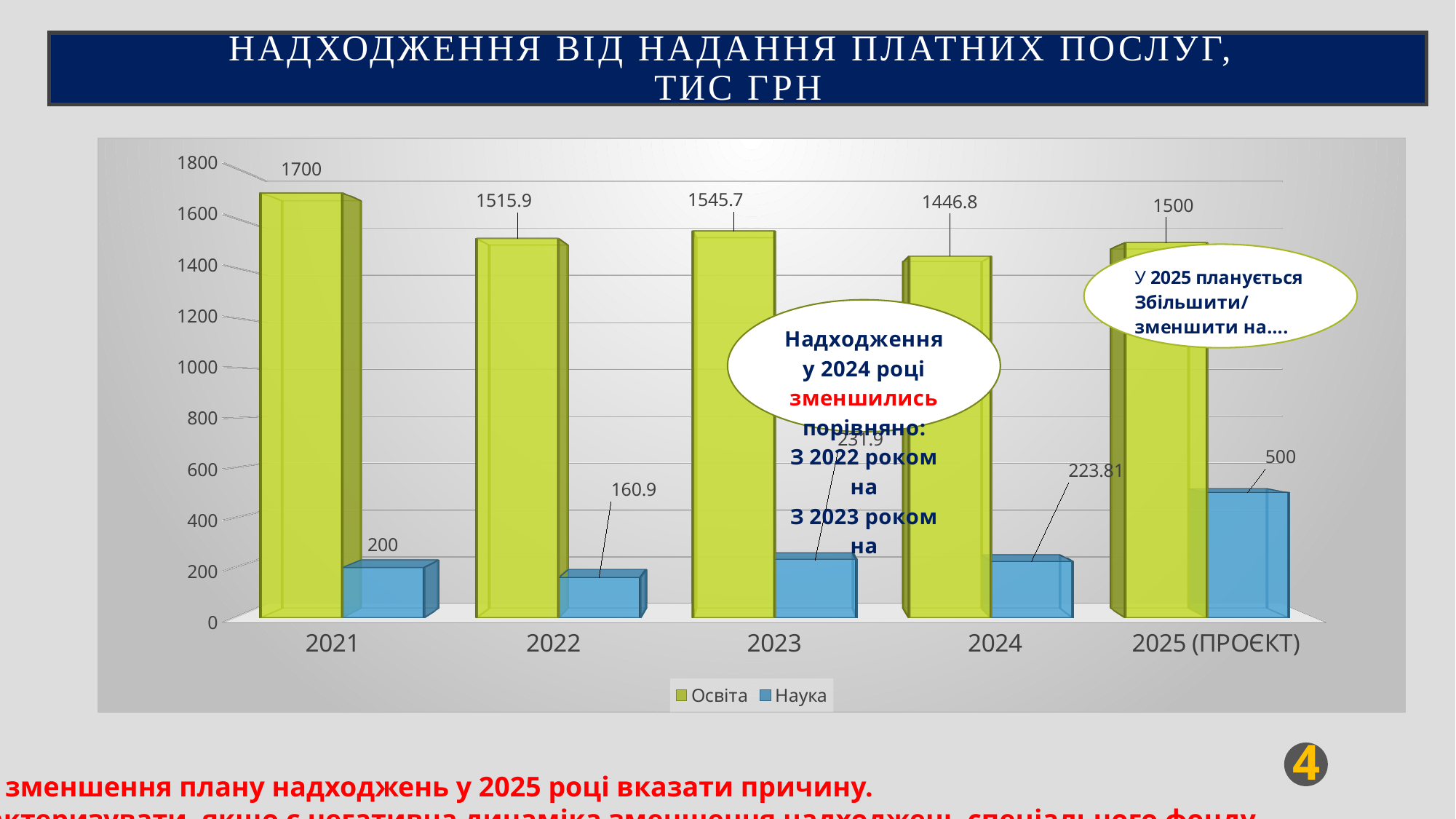
What kind of chart is shown on the slide? Bar chart Which year has the lowest value for Наука? 2022 What is the value for Наука in 2024? 223.81 Is the value for Наука in 2025 (ПРОЄКТ) greater or less than 400? greater Which year has the highest value for Освіта? 2021 How many series does the legend list? 2 Which is larger, the Освіта value for 2023 or for 2024? 2023 What is the value for Наука in 2022? 160.9 What is the difference between the Освіта values for 2021 and 2022? 184.1 What is the value for Наука in 2025 (ПРОЄКТ)? 500 What is the value for Освіта in 2024? 1446.8 What is the value for Освіта in 2021? 1700